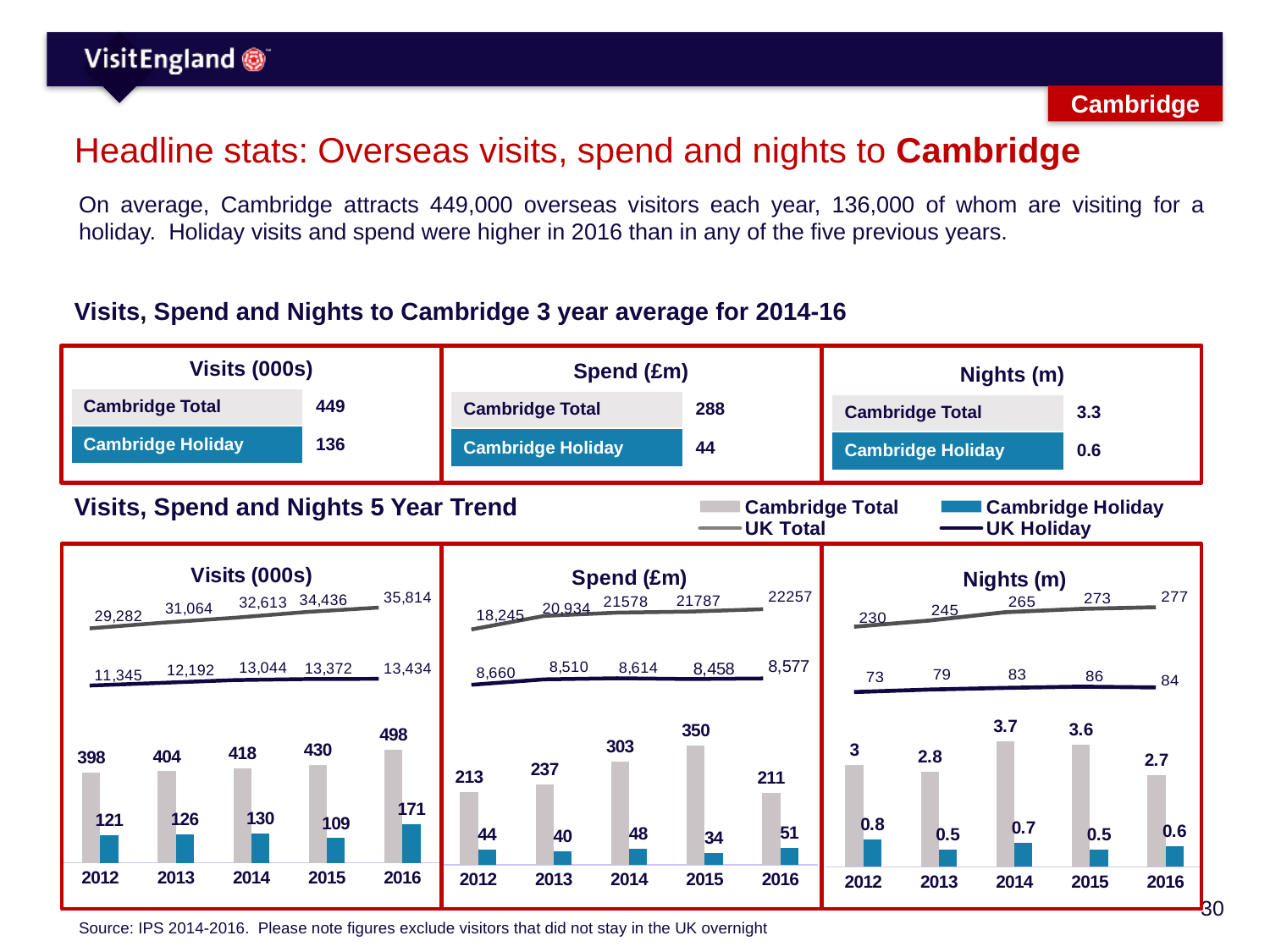
How many series does the legend for the 5 Year Trend charts list? 4 In the Spend (£m) trend chart, what is the UK Holiday value for 2012? 8,660 What kind of chart is the Visits (000s) 5 Year Trend chart? Combined bar and line chart In the Nights (m) trend chart, is the Cambridge Total value larger in 2014 or in 2016? 2014 In the Visits (000s) trend chart, which year has the lowest Cambridge Holiday value? 2015 How many years are shown on the x axis of the Spend (£m) trend chart? 5 In the Spend (£m) trend chart, what is the Cambridge Holiday value for 2015? 34 In the Visits (000s) trend chart, what is the Cambridge Total value for 2016? 498 In the Visits (000s) trend chart, what is the difference between the Cambridge Total values for 2016 and 2012? 100 In the Visits (000s) trend chart, does the UK Total line rise or fall from 2012 to 2016? Rises In the Spend (£m) trend chart, which year has the highest Cambridge Total value? 2015 In the Nights (m) trend chart, what is the UK Total value for 2014? 265